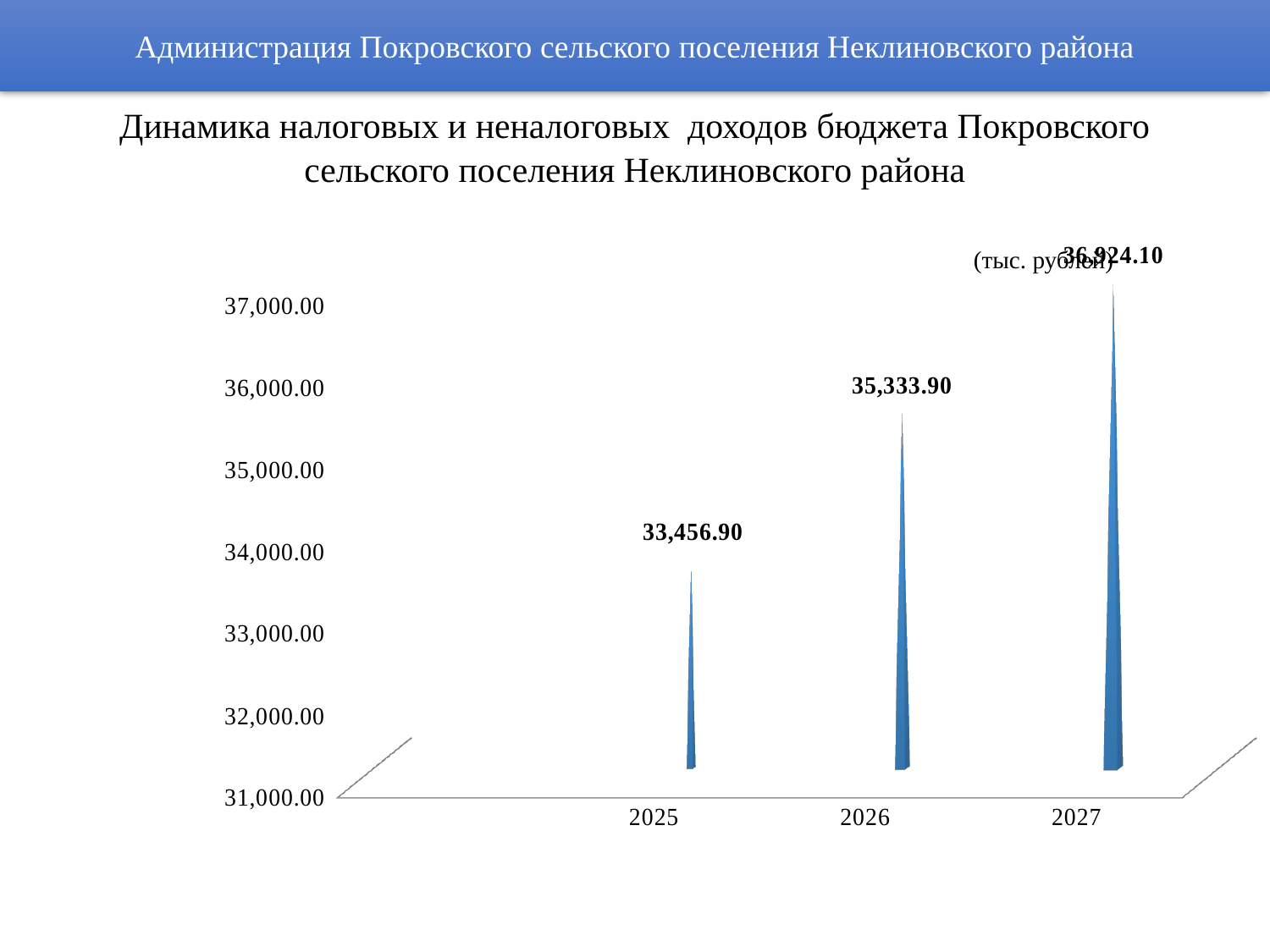
What is the difference between the values for 2026 and 2025? 1,877.00 How many years are shown on the x axis? 3 Do the values rise or fall from 2025 to 2027? rise What kind of chart is shown? bar chart Which year has the highest value? 2027 What is the value for 2025? 33,456.90 What is the difference between the values for 2027 and 2026? 1,590.20 What is the value for 2027? 36,924.10 Which is larger, the value for 2025 or the value for 2026? 2026 Is the value for 2025 greater or less than 34,000.00? less What is the value for 2026? 35,333.90 Which year has the lowest value? 2025